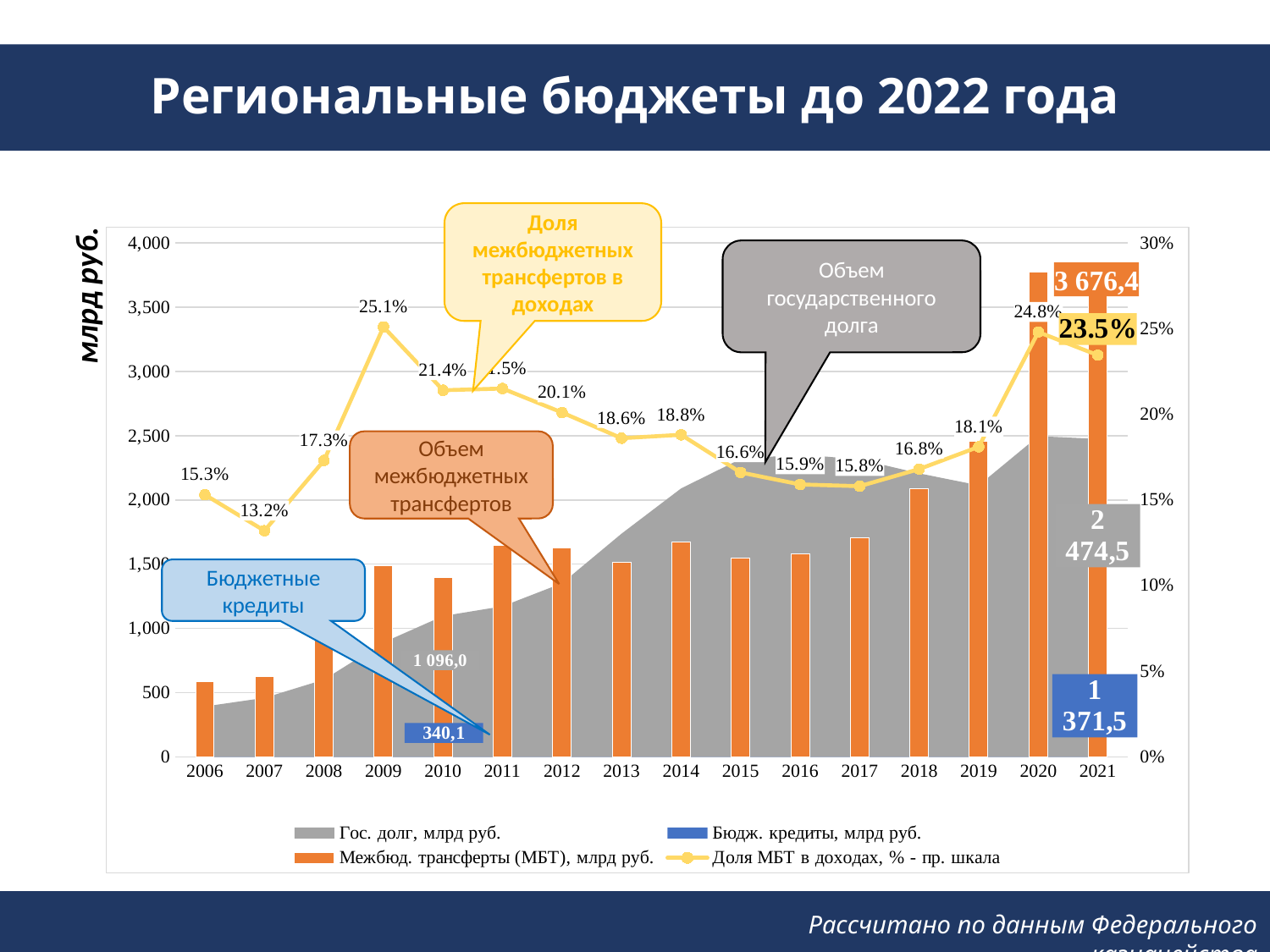
What kind of chart is shown on the slide? A combination chart of bars, an area and a line Is the value of Межбюд. трансферты (МБТ) for 2006 greater or less than 1,000? less In which year is Доля МБТ в доходах the highest? 2009 How many series does the legend list? 4 What is the value of Бюдж. кредиты for 2021? 1 371,5 What is the value of Доля МБТ в доходах for 2009? 25.1% In which year is Доля МБТ в доходах the lowest? 2007 What is the value of Межбюд. трансферты (МБТ) for 2021? 3 676,4 How many years are shown on the x axis? 16 What is the value of Доля МБТ в доходах for 2021? 23.5% What is the value of Гос. долг for 2021? 2 474,5 By how many percentage points does Доля МБТ в доходах differ between 2020 and 2021? 1.3 percentage points